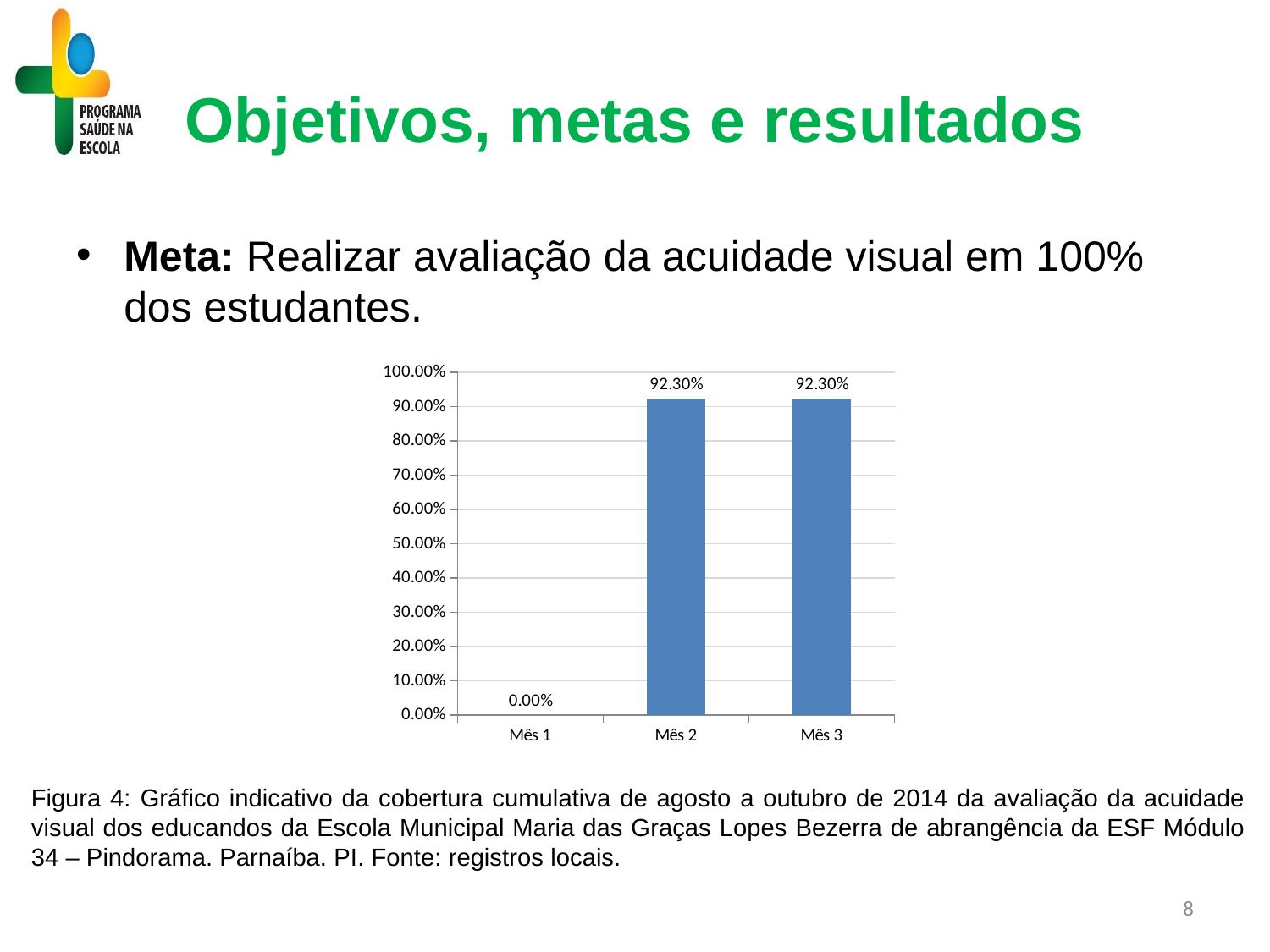
Is the value for Mês 3 greater or less than 50.00%? greater What is the highest value shown on the y axis? 100.00% Which is larger, the value for Mês 1 or the value for Mês 2? Mês 2 What is the value for Mês 1? 0.00% Do the values rise or fall from Mês 1 to Mês 2? rise Which category has the lowest value? Mês 1 What colour are the bars in the chart? blue What is the value for Mês 2? 92.30% What kind of chart is shown on the slide? bar chart How many categories are shown on the x axis? 3 What is the difference between the values for Mês 2 and Mês 1? 92.30% What is the value for Mês 3? 92.30%